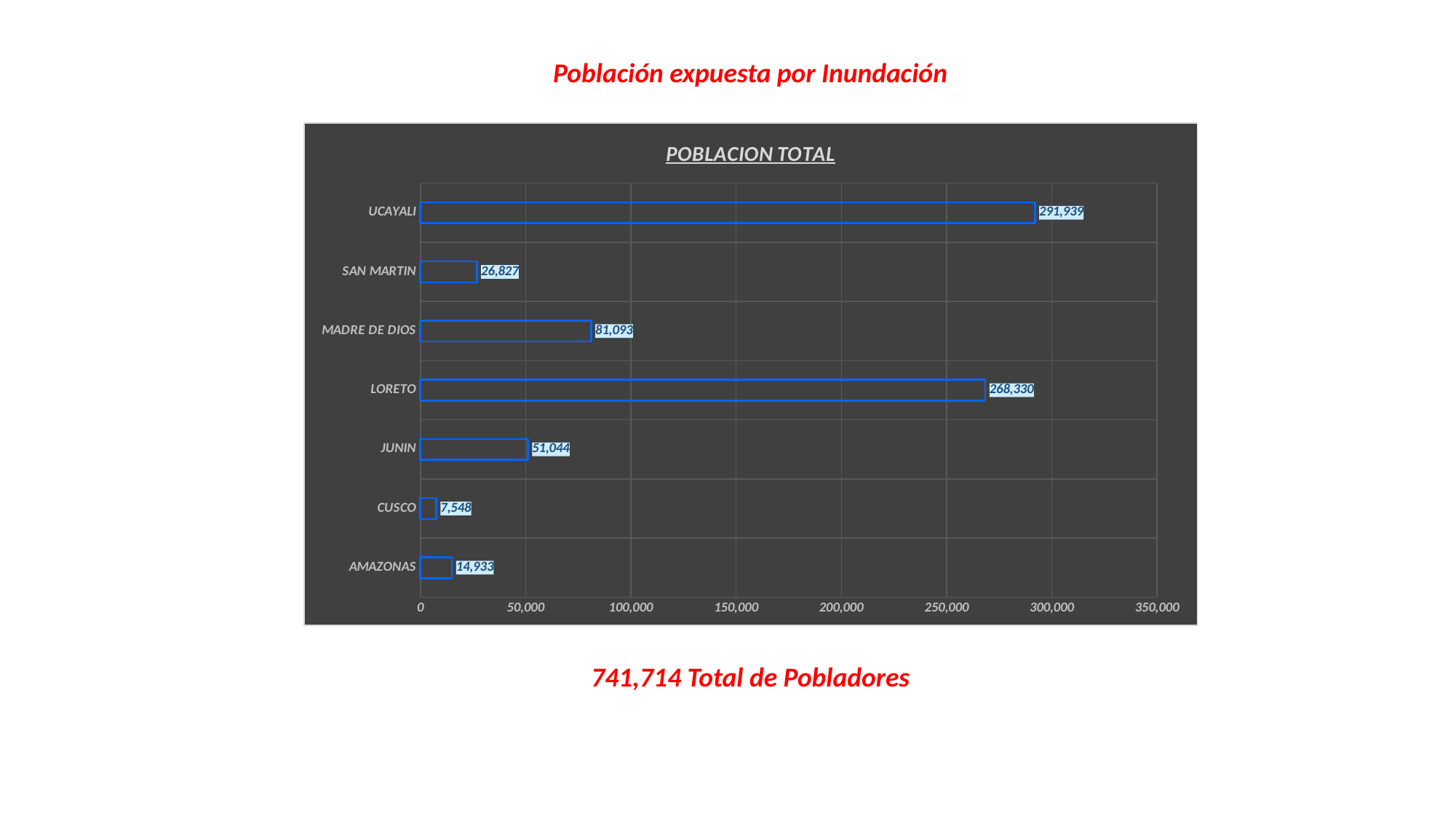
What is the difference between the values for UCAYALI and LORETO? 23,609 What is the difference between the values for MADRE DE DIOS and JUNIN? 30,049 What is the title of the chart? POBLACION TOTAL What is the value for MADRE DE DIOS? 81,093 What kind of chart is shown on the slide? bar chart What is the value for UCAYALI? 291,939 Which is larger, the value for SAN MARTIN or the value for AMAZONAS? SAN MARTIN What is the value for CUSCO? 7,548 Is the value for LORETO greater or less than 250,000? greater Which category has the highest value? UCAYALI How many categories are shown in the chart? 7 Which category has the lowest value? CUSCO